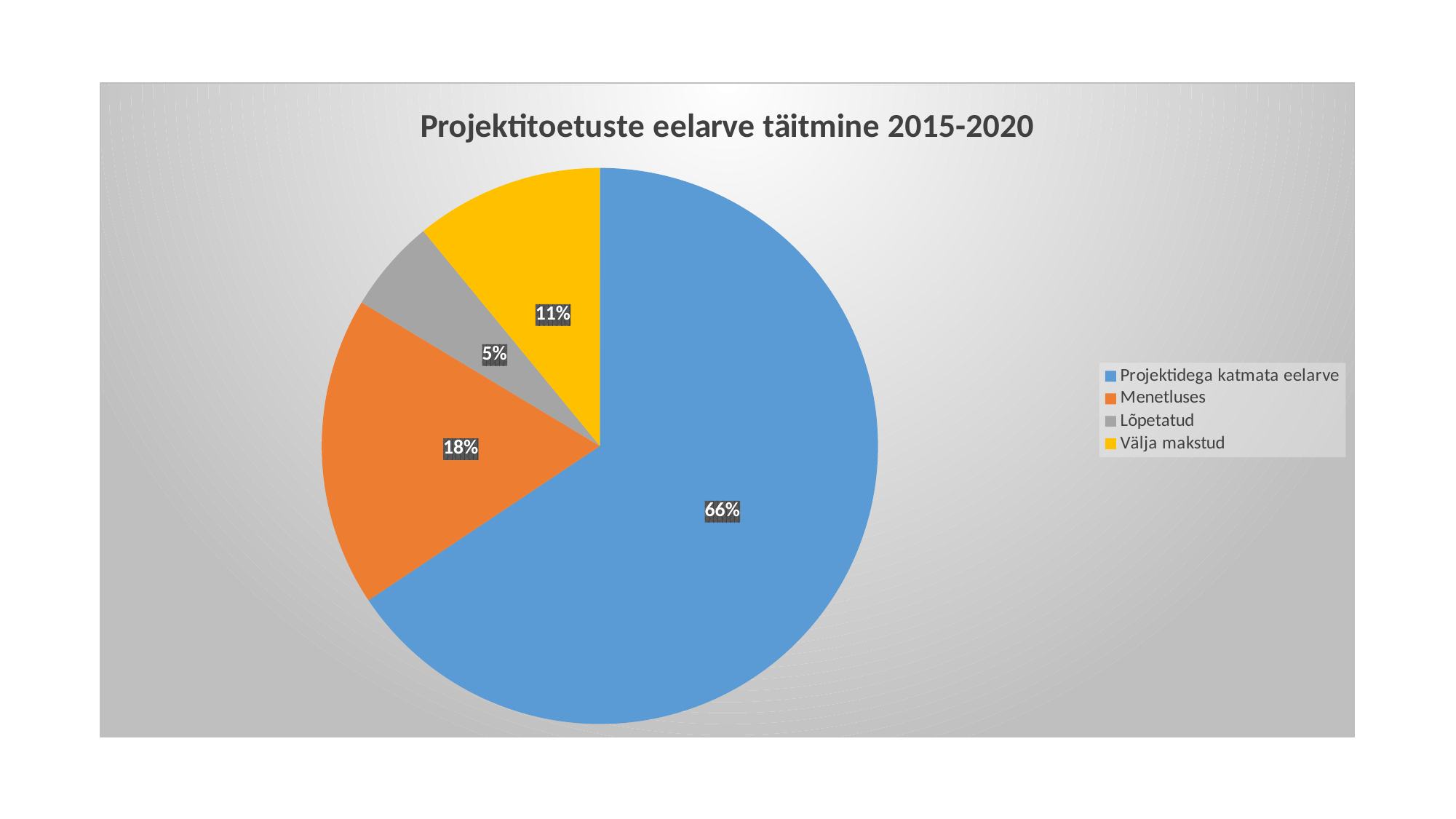
What share of the pie does Lõpetatud take? 5% What share of the pie does Projektidega katmata eelarve take? 66% What is the difference in percentage points between Menetluses and Välja makstud? 7 Which colour represents Menetluses in the legend? orange What is the title of the chart? Projektitoetuste eelarve täitmine 2015-2020 How many slices does the pie chart have? 4 Which category has the largest slice of the pie? Projektidega katmata eelarve Which category has the smallest slice of the pie? Lõpetatud What share of the pie does Välja makstud take? 11% Which is larger, the share for Välja makstud or the share for Lõpetatud? Välja makstud What kind of chart is shown on the slide? pie chart